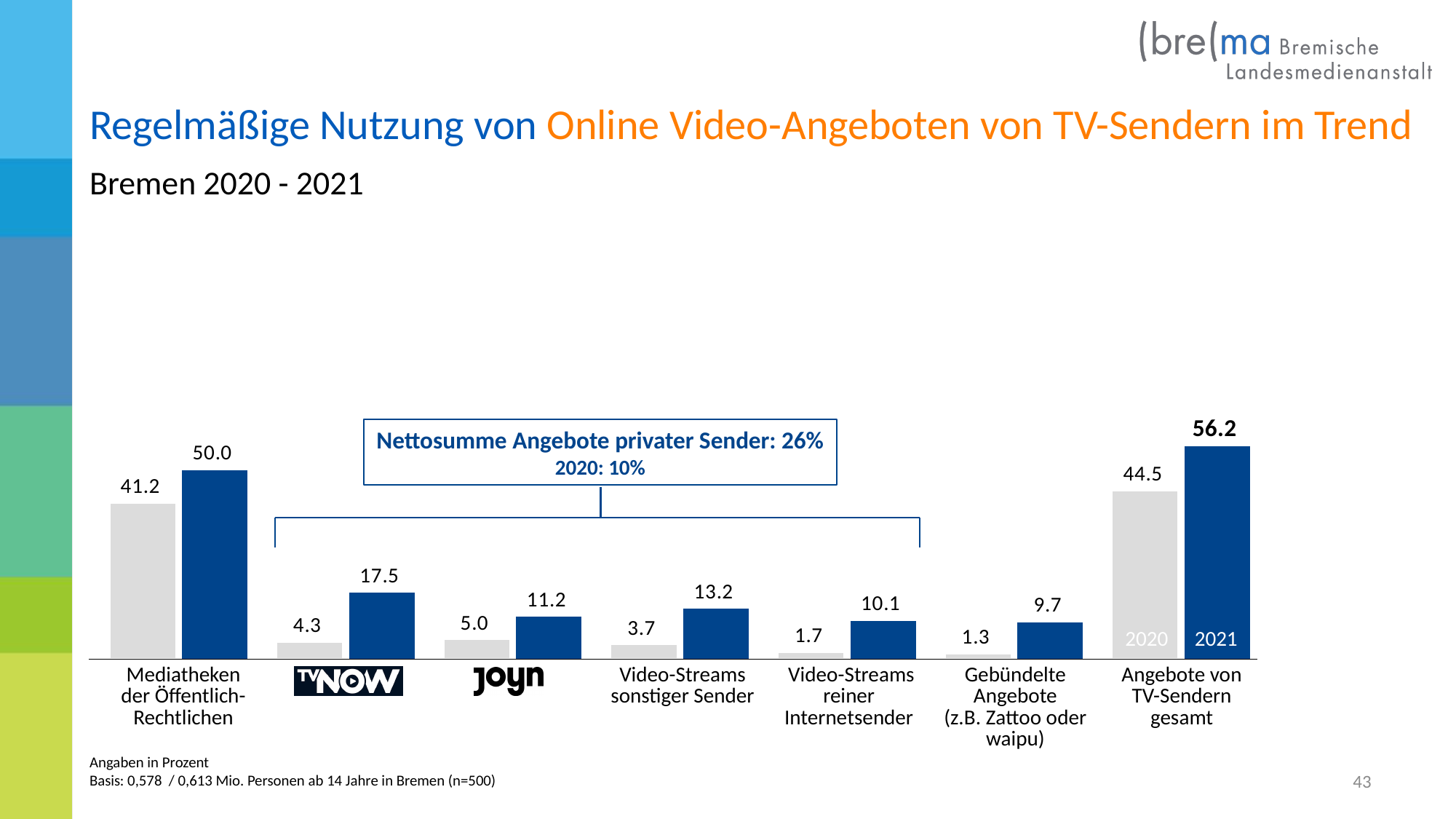
What kind of chart is shown on the slide? bar chart What is the 2020 value for TV NOW? 4.3 How many series does the chart show? 2 Which is larger: the 2021 value for Video-Streams sonstiger Sender or the 2021 value for Video-Streams reiner Internetsender? Video-Streams sonstiger Sender What is the 2021 value for Mediatheken der Öffentlich-Rechtlichen? 50.0 How many categories are shown on the x axis? 7 Which category has the highest 2021 value? Angebote von TV-Sendern gesamt What is the Nettosumme Angebote privater Sender for 2020 according to the box on the chart? 10% What is the 2021 value for Joyn? 11.2 Which category has the lowest 2020 value? Gebündelte Angebote (z.B. Zattoo oder waipu) What is the difference between the 2021 and 2020 values for Angebote von TV-Sendern gesamt? 11.7 What is the 2020 value for Video-Streams reiner Internetsender? 1.7